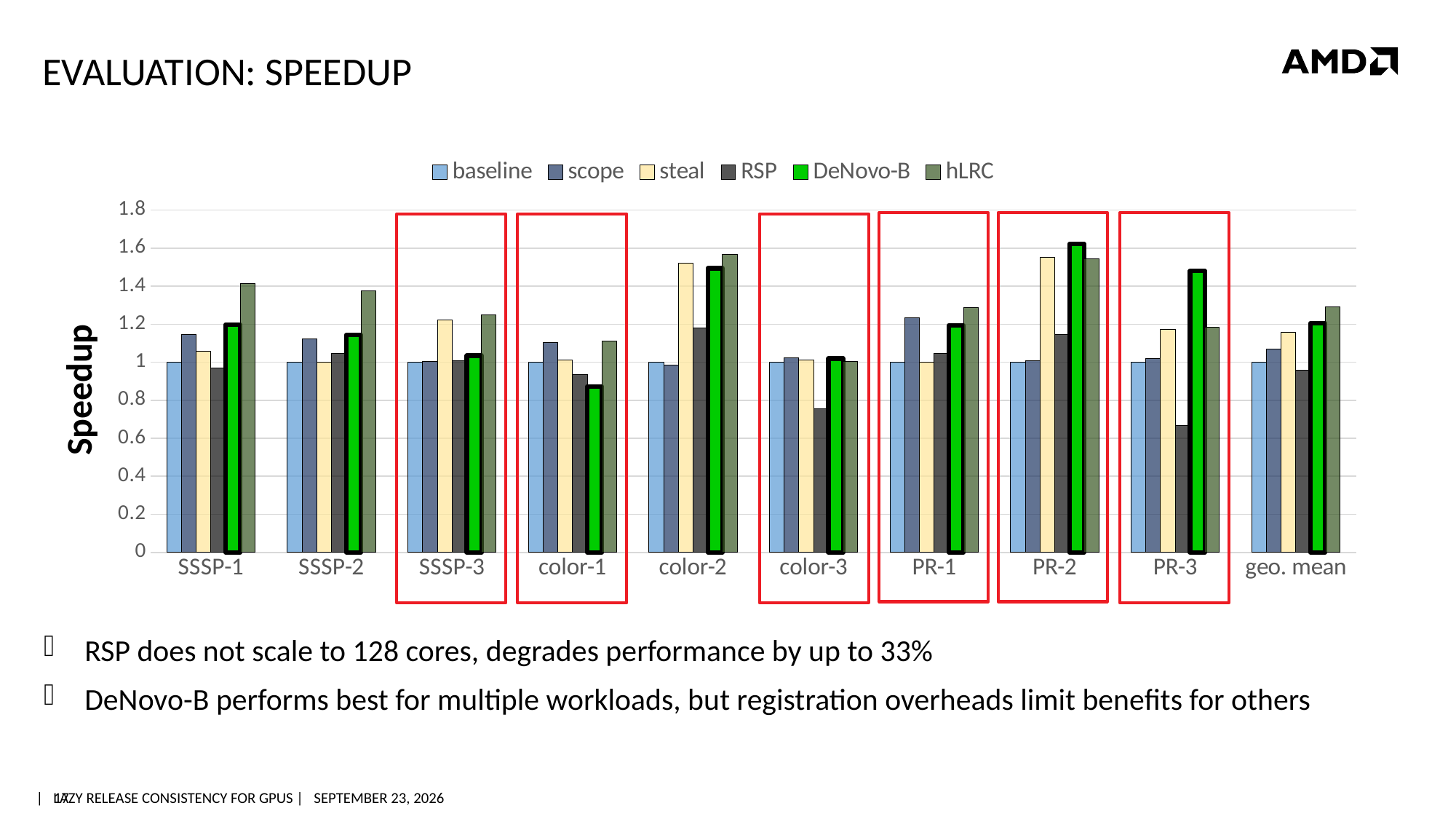
Is the RSP speedup for PR-3 greater or less than 0.8? less Is the DeNovo-B speedup for color-1 greater or less than 1? less How many series does the legend list? 6 What kind of chart is shown on the slide? bar chart How many workload categories are shown along the x axis? 10 For PR-3, which is larger: the steal speedup or the DeNovo-B speedup? DeNovo-B What is the label on the y axis? Speedup Is the DeNovo-B speedup for PR-2 greater or less than 1.4? greater What is the baseline speedup for SSSP-1? 1 Which series has the lowest speedup for color-3? RSP Which series has the highest speedup for PR-3? DeNovo-B